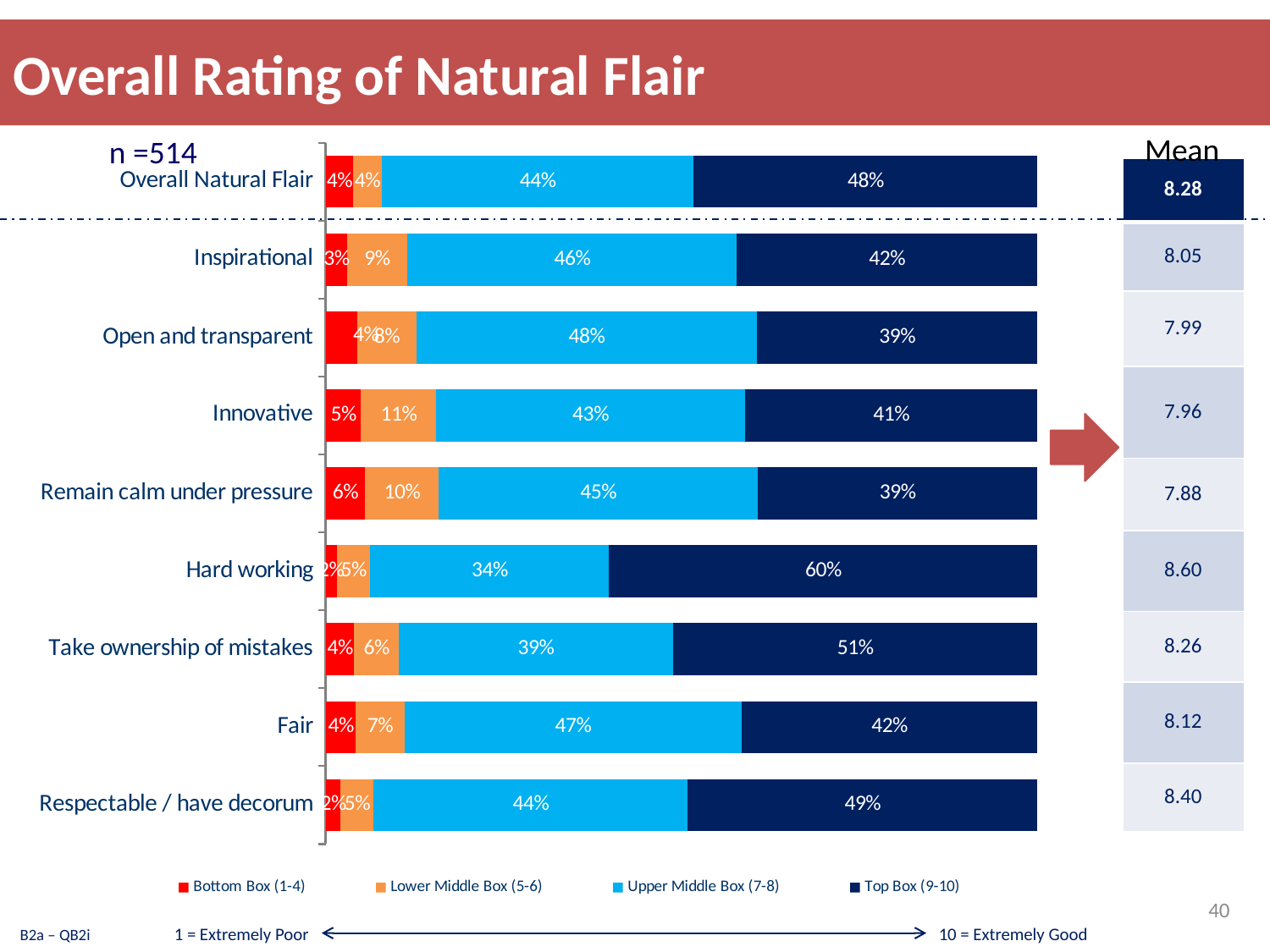
Which attribute has the highest Top Box (9-10) percentage? Hard working What is the sample size (n) shown on the slide? 514 What percentage of respondents gave a Top Box (9-10) rating for Hard working? 60% What is the Bottom Box (1-4) value for Remain calm under pressure? 6% Which has a larger Top Box (9-10) value, Take ownership of mistakes or Fair? Take ownership of mistakes What is the total of the four segments for Innovative? 100% What is the Upper Middle Box (7-8) value for Fair? 47% How many attributes are plotted in the chart? 9 How many series does the legend list? 4 Which attribute has the lowest Upper Middle Box (7-8) percentage? Hard working What type of chart is shown on the slide? Stacked bar chart How many percentage points higher is the Top Box (9-10) value for Hard working than for Innovative? 19 percentage points